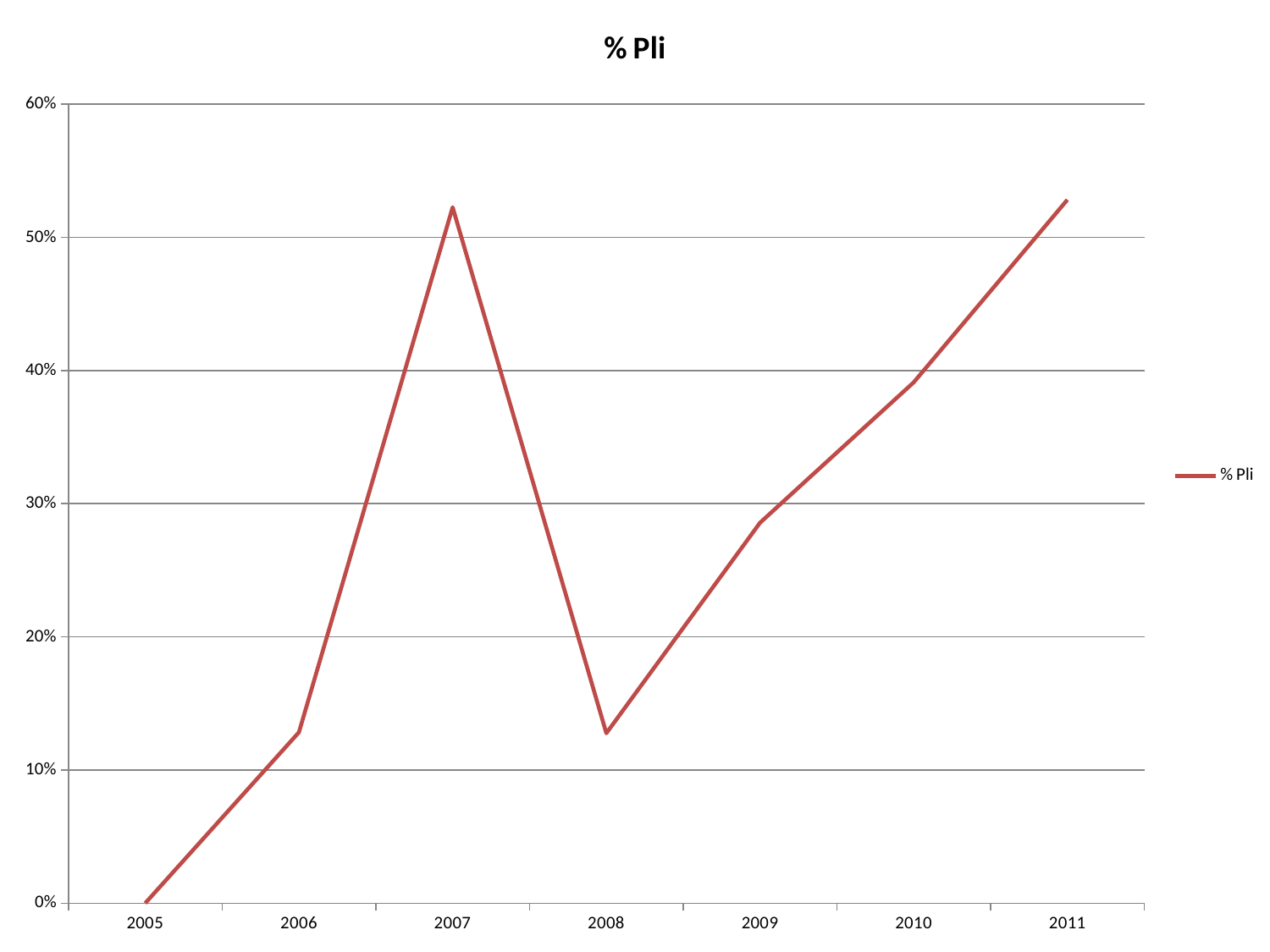
What is the value for 2005? 0% Do the values rise or fall from 2008 to 2011? rise Is the value for 2008 greater or less than 20%? less How many series does the legend list? 1 Is the value for 2010 greater or less than 40%? less Is the value for 2007 greater or less than 50%? greater Which year has the lowest value? 2005 What is the title of the chart? % Pli What kind of chart is shown on the slide? line chart How many years are plotted along the x axis? 7 Which is larger, the value for 2007 or the value for 2008? 2007